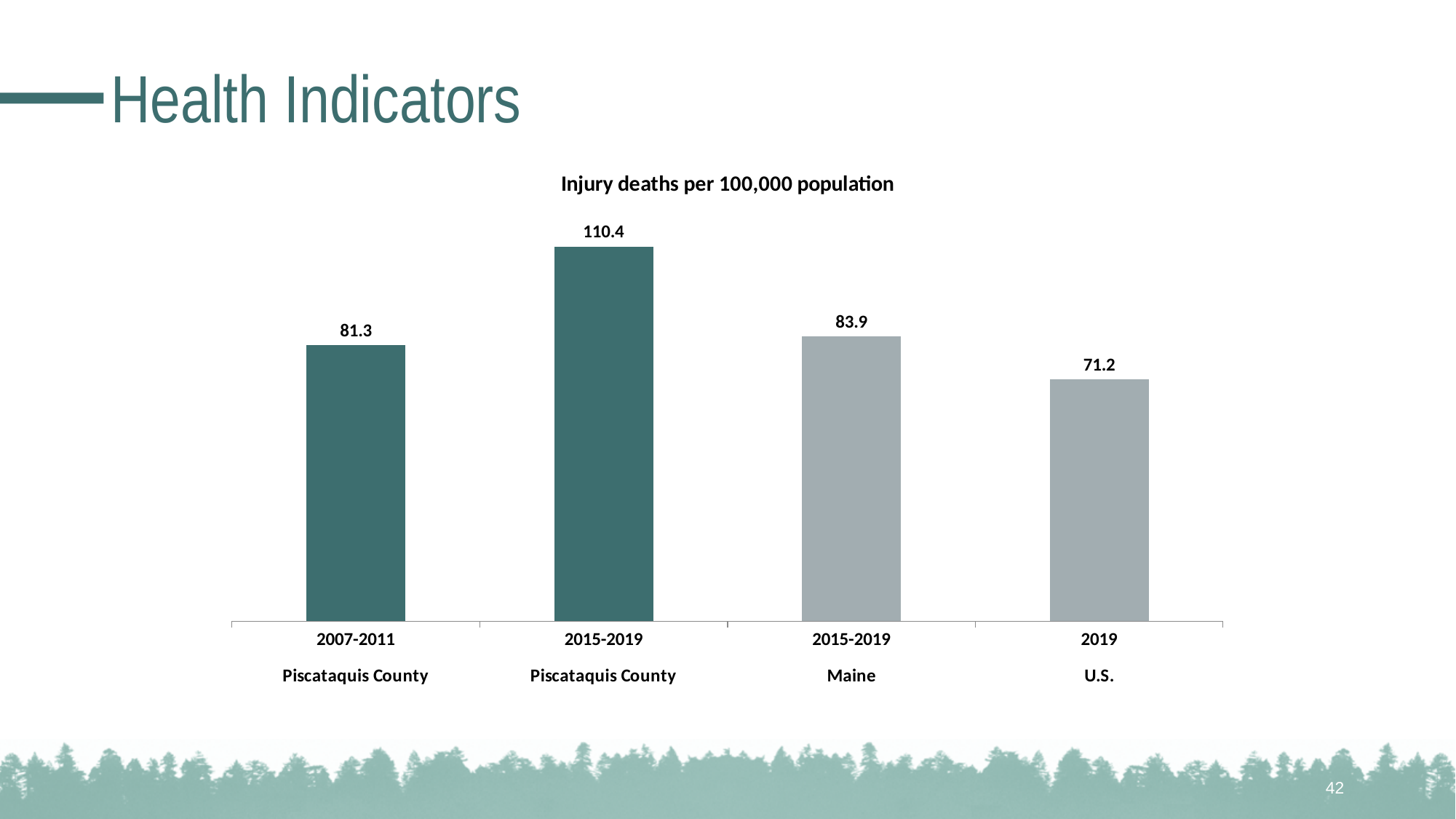
What is the difference between the Piscataquis County 2015-2019 value and the Piscataquis County 2007-2011 value? 29.1 Which is larger, the value for Maine 2015-2019 or the value for the U.S. 2019? Maine 2015-2019 What is the value for Piscataquis County in 2015-2019? 110.4 What is the title of the chart? Injury deaths per 100,000 population Which bar has the lowest value? U.S. 2019 What kind of chart is shown on the slide? Bar chart What is the difference between the Piscataquis County 2015-2019 value and the Maine 2015-2019 value? 26.5 What is the value for the U.S. in 2019? 71.2 What is the value for Maine in 2015-2019? 83.9 How many bars are shown in the chart? 4 Which bar has the highest value? Piscataquis County 2015-2019 What is the value for Piscataquis County in 2007-2011? 81.3